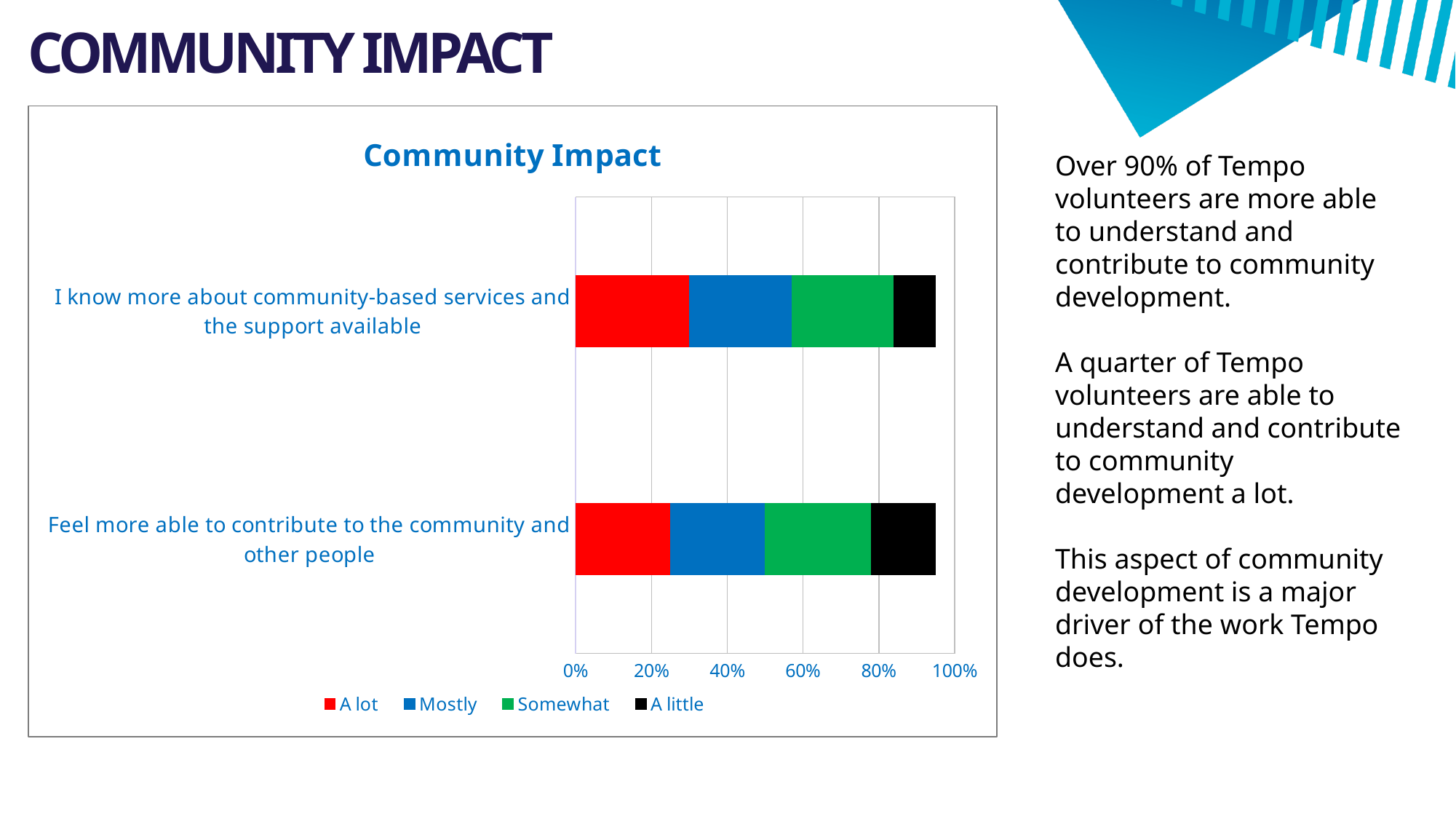
What is the title of the chart? Community Impact Which colour represents the 'Somewhat' series in the chart? Green Is the 'A lot' value for 'Feel more able to contribute to the community and other people' greater or less than 40%? less How many series does the chart's legend list? 4 Is the 'A lot' value for 'I know more about community-based services and the support available' greater or less than 20%? greater Is the total length of the bar for 'I know more about community-based services and the support available' greater or less than 80%? greater Which category has the larger 'A lot' segment: 'I know more about community-based services and the support available' or 'Feel more able to contribute to the community and other people'? I know more about community-based services and the support available How many categories (bars) does the chart show? 2 Which category has the larger 'A little' segment: 'I know more about community-based services and the support available' or 'Feel more able to contribute to the community and other people'? Feel more able to contribute to the community and other people What kind of chart is shown on the slide? Stacked bar chart